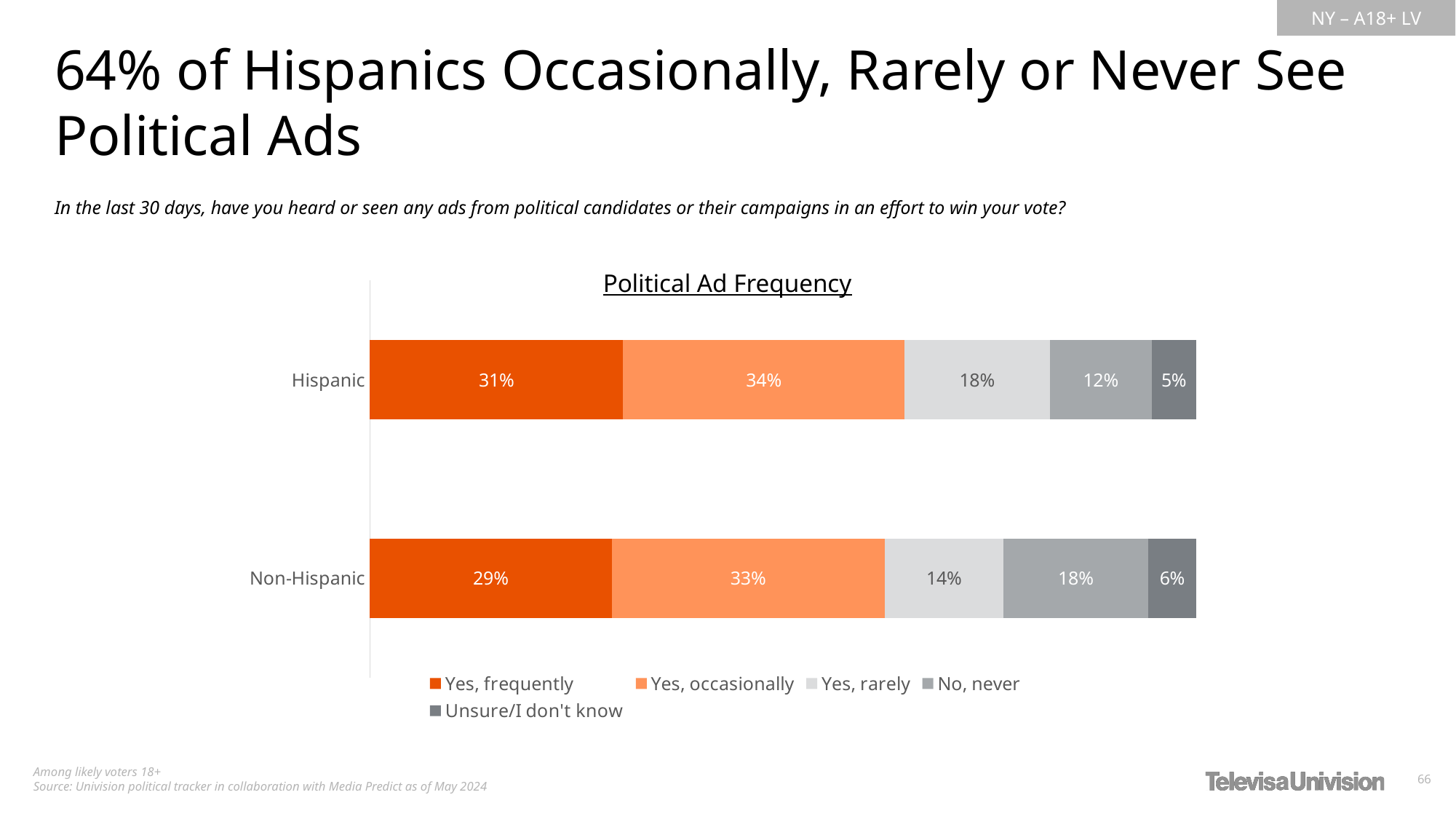
Which group has the larger 'No, never' value, Hispanic or Non-Hispanic? Non-Hispanic What is the difference between the 'Yes, rarely' values for Hispanic and Non-Hispanic respondents? 4 percentage points What type of chart is shown on the slide? Stacked bar chart How many series does the legend list? 5 What is the title of the chart? Political Ad Frequency Which response category has the highest value for Hispanic respondents? Yes, occasionally How many groups (bars) are shown in the chart? 2 Which response category has the lowest value for Non-Hispanic respondents? Unsure/I don't know What is the 'Unsure/I don't know' value for Non-Hispanic respondents? 6% What percentage of Hispanic respondents said they see political ads frequently? 31% What is the 'Yes, occasionally' value for Non-Hispanic respondents? 33% What share of Hispanic respondents answered 'No, never'? 12%